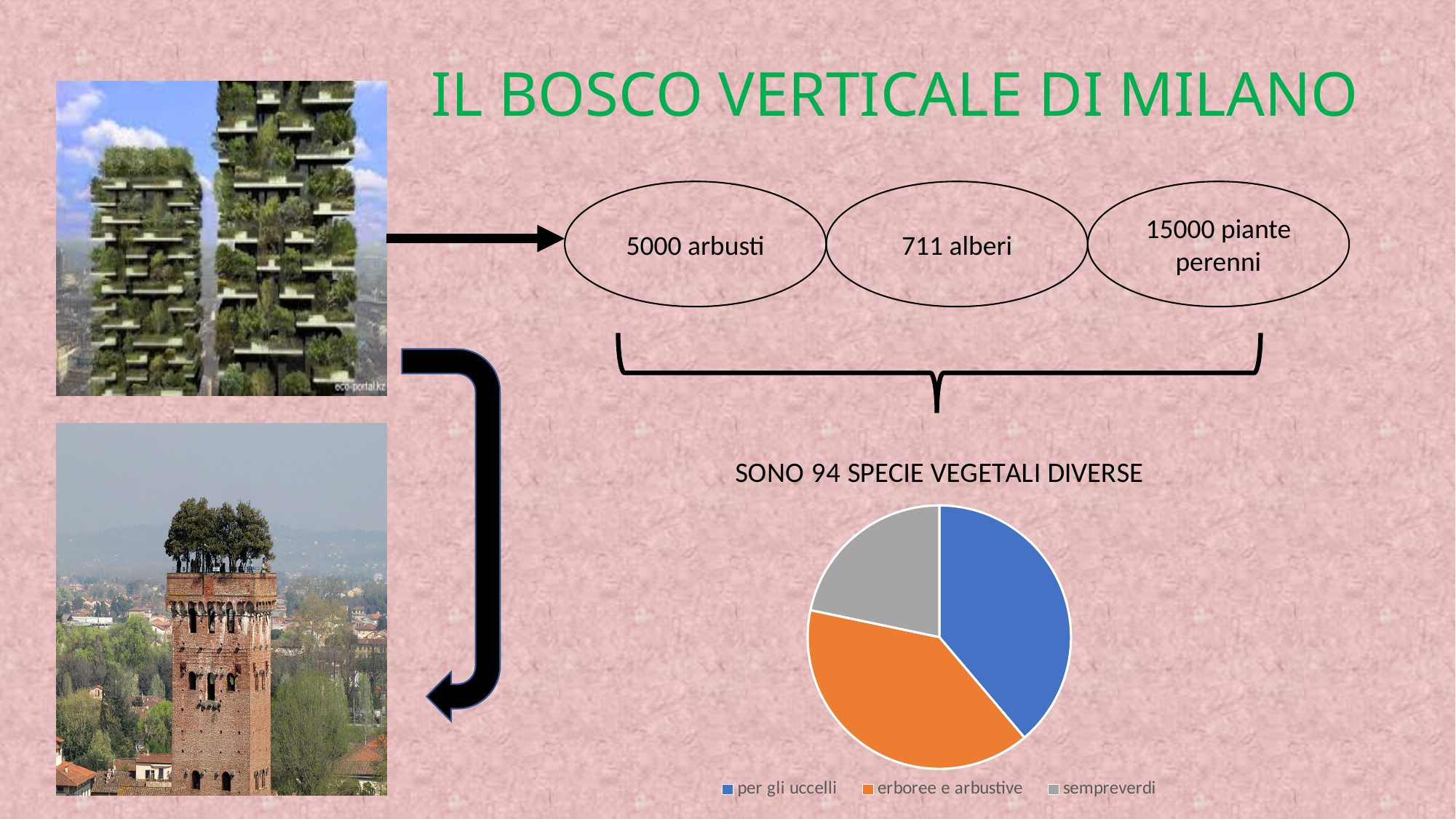
In the pie chart, which slice is larger: 'erboree e arbustive' or 'sempreverdi'? erboree e arbustive Which category has the smallest slice in the pie chart? sempreverdi Which colour represents 'erboree e arbustive' in the pie chart? orange How many slices does the pie chart have? 3 In the pie chart, which slice is larger: 'per gli uccelli' or 'sempreverdi'? per gli uccelli What kind of chart is shown on the slide? pie chart How many entries does the legend of the pie chart list? 3 What is the title shown above the pie chart? SONO 94 SPECIE VEGETALI DIVERSE